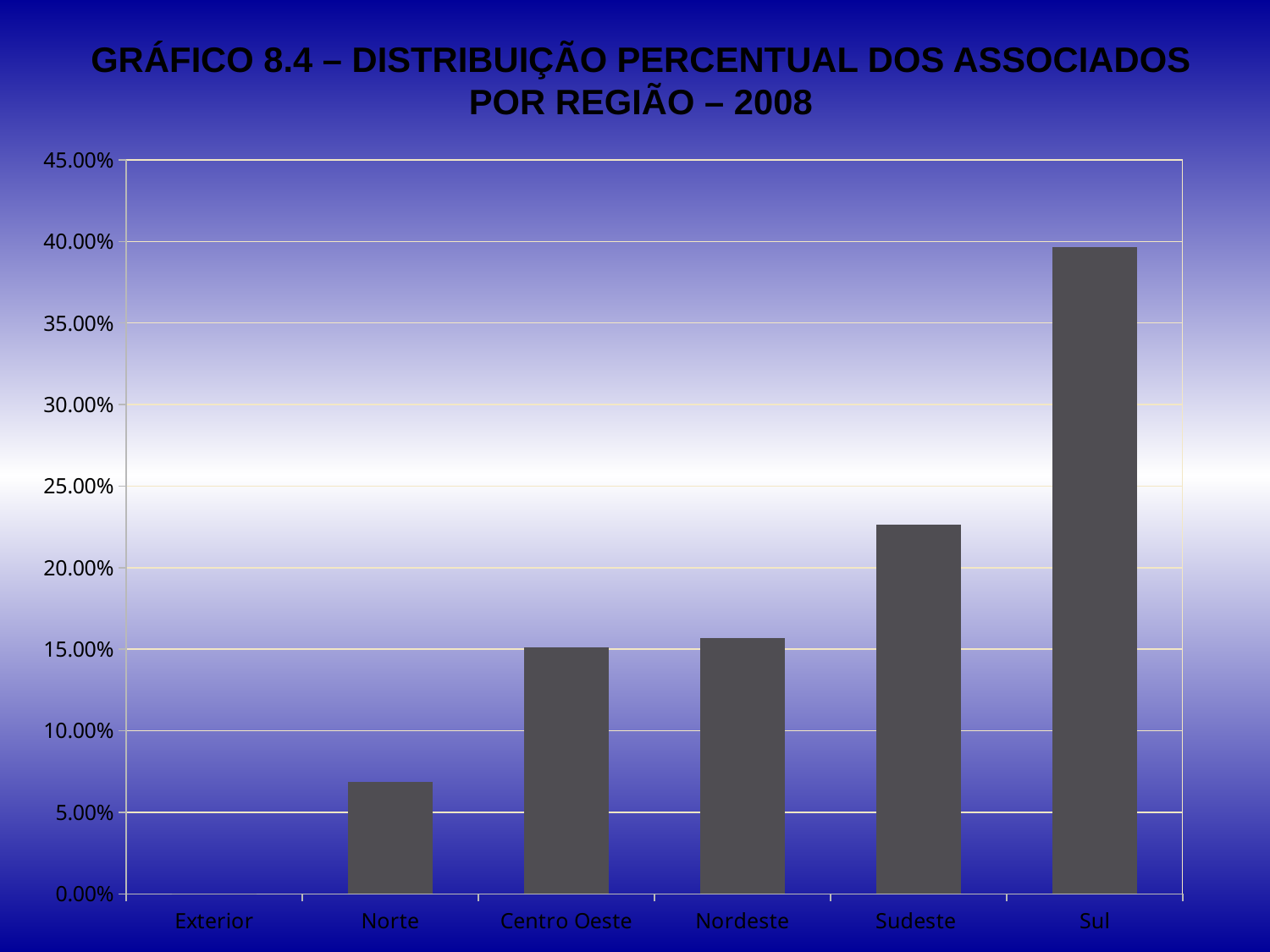
Is the value for Sudeste greater or less than 20.00%? greater Is the value for Norte greater or less than 10.00%? less How many regions are shown on the x axis? 6 Which is larger, the value for Sudeste or the value for Nordeste? Sudeste Which year does the chart title refer to? 2008 Is the value for Centro Oeste greater or less than 20.00%? less Which region has the highest bar in the chart? Sul Which is larger, the value for Norte or the value for Centro Oeste? Centro Oeste Which region has the lowest value in the chart? Exterior Do the values generally rise or fall from left to right along the x axis? Rise What kind of chart is shown on the slide? Bar chart